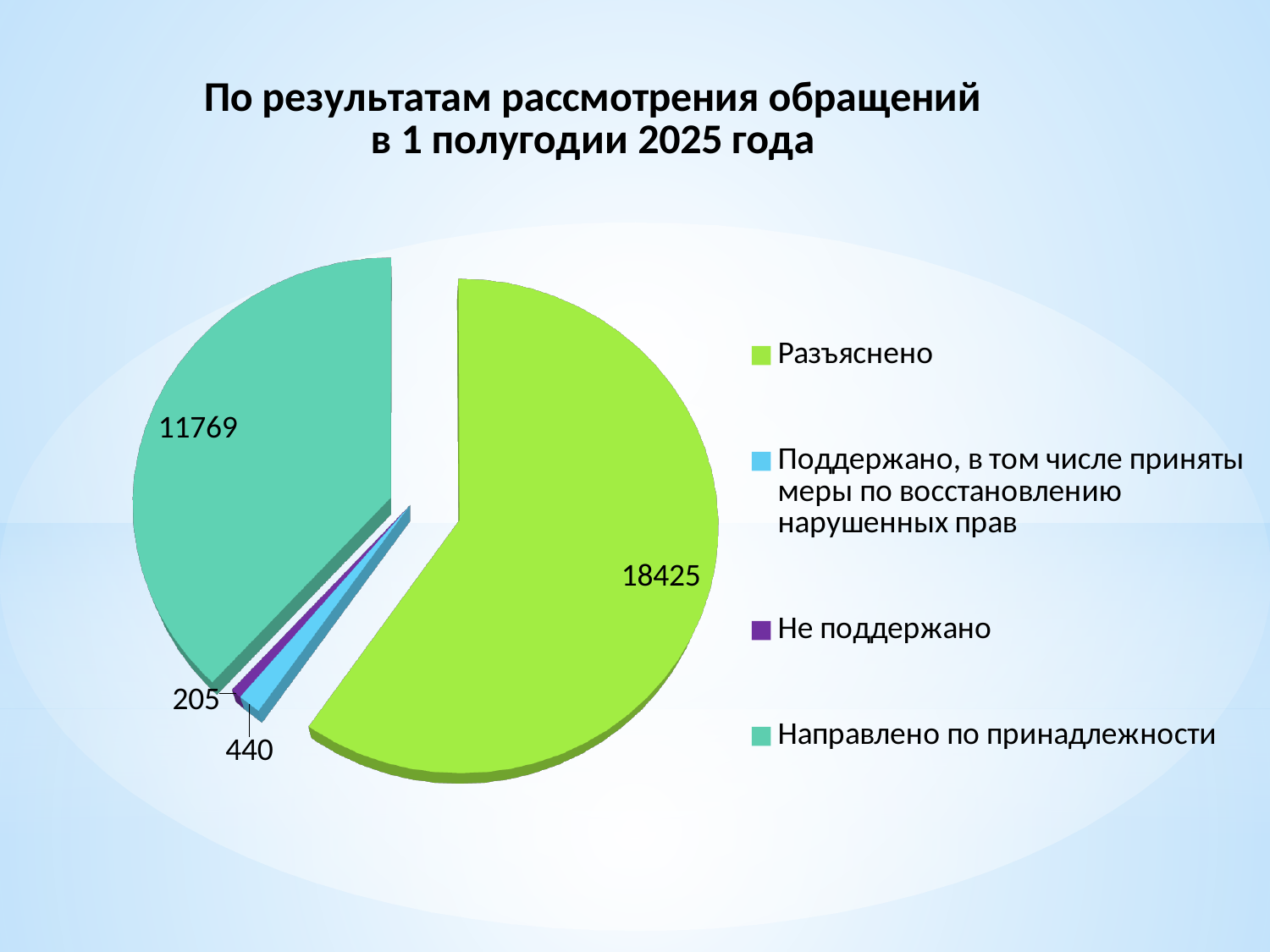
What is the value for Разъяснено? 18425 Which category has the largest slice of the pie? Разъяснено What is the value for Поддержано, в том числе приняты меры по восстановлению нарушенных прав? 440 What is the difference between the values for Разъяснено and Направлено по принадлежности? 6656 Which category has the smallest slice of the pie? Не поддержано What is the title of the slide? По результатам рассмотрения обращений в 1 полугодии 2025 года What is the value for Не поддержано? 205 What is the value for Направлено по принадлежности? 11769 What type of chart is shown on the slide? Pie chart What is the difference between the values for Поддержано and Не поддержано? 235 How many categories does the pie chart have? 4 Which is larger, the value for Направлено по принадлежности or the value for Поддержано? Направлено по принадлежности